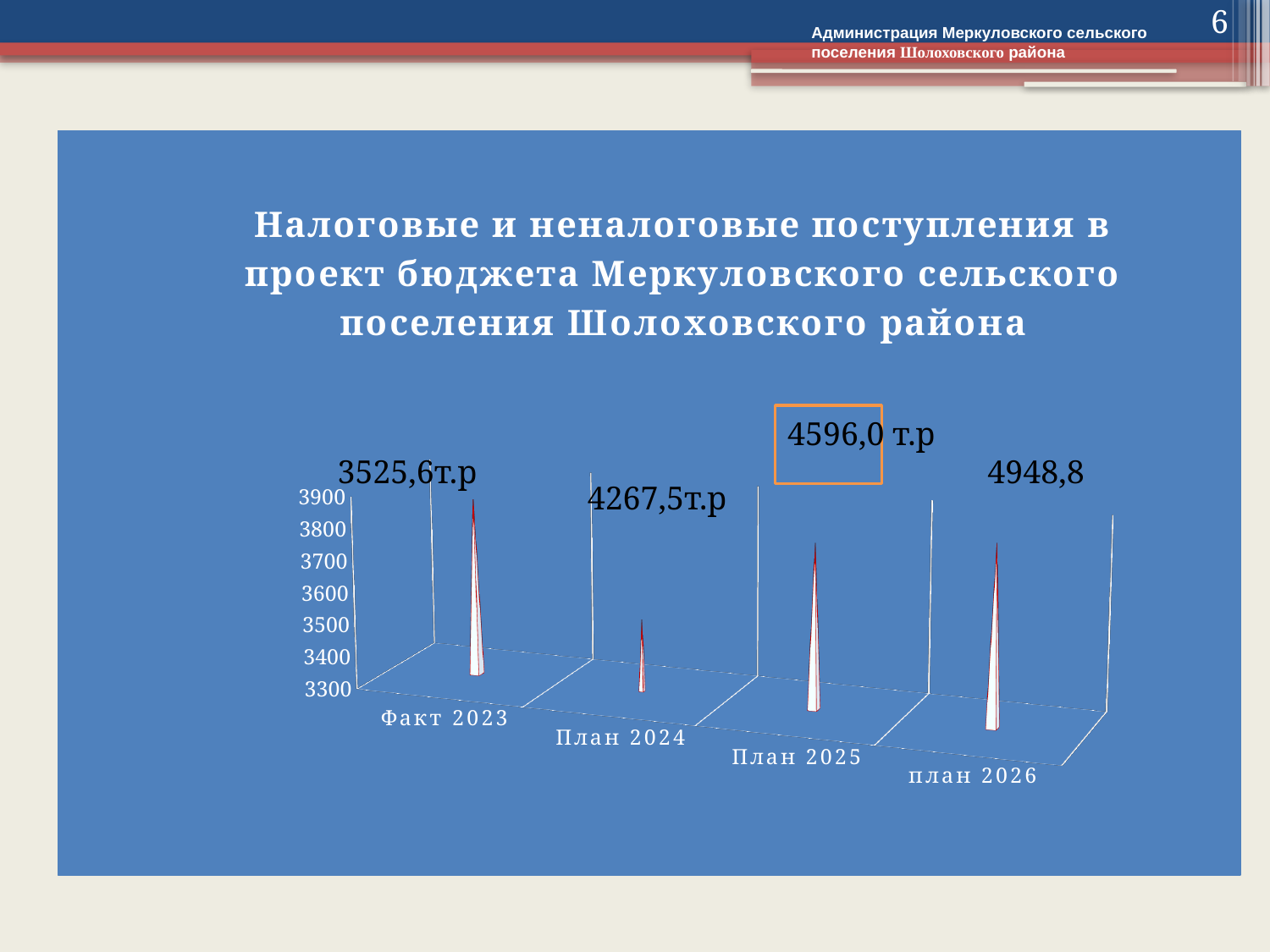
What value is labelled for План 2025? 4596,0 т.р According to the data labels, which category has the highest value? план 2026 What value is labelled for Факт 2023? 3525,6т.р Which labelled value is larger, План 2024 or План 2025? План 2025 What is the difference between the labelled values for План 2025 and План 2024? 328,5 Do the labelled values rise or fall from Факт 2023 to план 2026? rise Which data label is highlighted with an orange box? 4596,0 т.р What value is labelled for план 2026? 4948,8 What value is labelled for План 2024? 4267,5т.р How many categories are shown on the x axis? 4 According to the data labels, which category has the lowest value? Факт 2023 What is the difference between the labelled values for план 2026 and Факт 2023? 1423,2